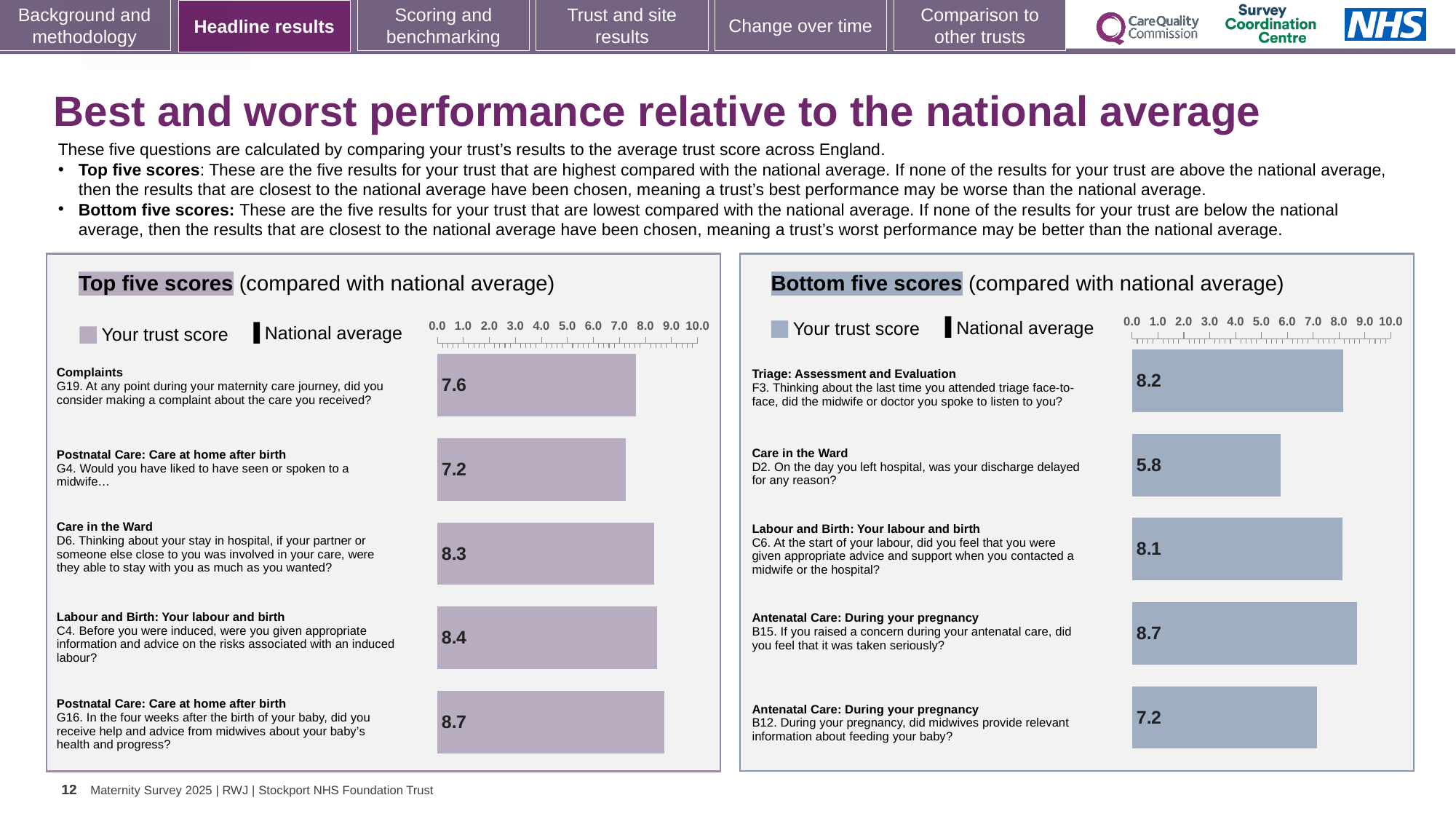
In the Bottom five scores chart, which has the larger trust score, F3 or C6? F3 In the Bottom five scores chart, what is the trust score for D2 (was your discharge delayed for any reason)? 5.8 How many bars are shown in the Top five scores chart? 5 In the Top five scores chart, what is the trust score for G19 (consider making a complaint about the care you received)? 7.6 In the Top five scores chart, which question has the highest trust score? G16 (8.7) What kind of chart is the Bottom five scores chart? Bar chart In the Top five scores chart, which question has the lowest trust score? G4 (7.2) In the Bottom five scores chart, what is the difference between the trust scores for B15 and B12? 1.5 In the Bottom five scores chart, which question has the lowest trust score? D2 (5.8) In the Top five scores chart, what is the difference between the trust scores for G16 and G4? 1.5 In the Top five scores chart, what is the trust score for C4 (information and advice on the risks associated with an induced labour)? 8.4 In the Bottom five scores chart, is the trust score for D2 greater or less than 6.0? less